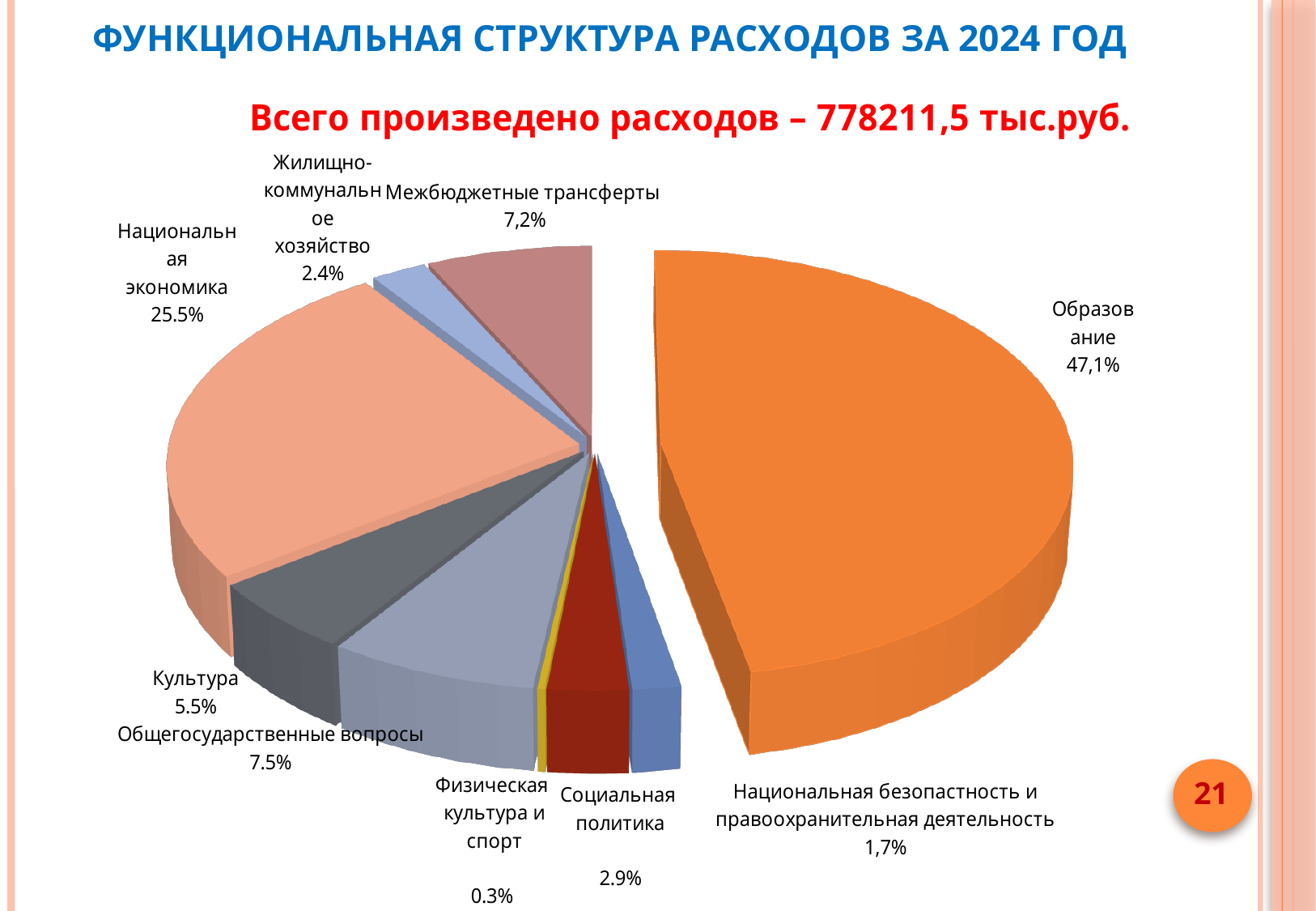
How many categories are shown in the pie chart? 9 Which has a larger share: Культура or Социальная политика? Культура What percentage is shown for Общегосударственные вопросы? 7.5% Which category has the smallest share of expenditures? Физическая культура и спорт What type of chart is shown on the slide? Pie chart What percentage is shown for Национальная безопасность и правоохранительная деятельность? 1,7% What share of expenditures does Образование account for? 47,1% What total amount of expenditures is stated on the slide? 778211,5 тыс.руб. What share of expenditures does Национальная экономика account for? 25.5% Which category has the largest share of expenditures? Образование What percentage is shown for Межбюджетные трансферты? 7,2% What is the difference in percentage points between Общегосударственные вопросы and Культура? 2.0%